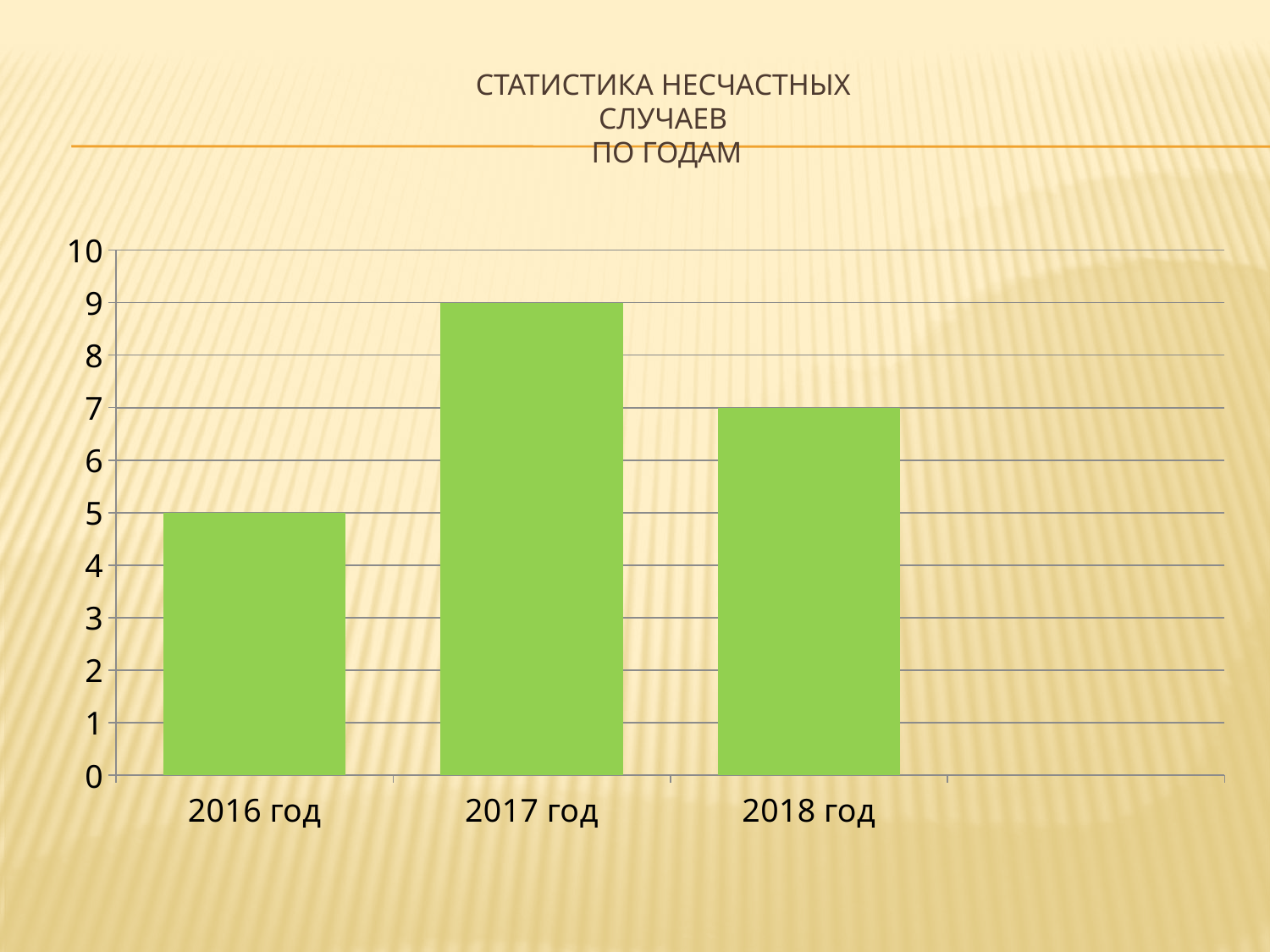
Is the value for 2017 год greater or less than 8? greater How many years are shown on the chart? 3 What is the difference between the values for 2017 год and 2018 год? 2 What is the value for 2017 год? 9 What kind of chart is shown on the slide? bar chart What is the difference between the values for 2017 год and 2016 год? 4 Which is larger, the value for 2018 год or the value for 2016 год? 2018 год What is the value for 2018 год? 7 What is the value for 2016 год? 5 Which year has the lowest value? 2016 год What is the title of the chart? Статистика несчастных случаев по годам Which year has the highest value? 2017 год